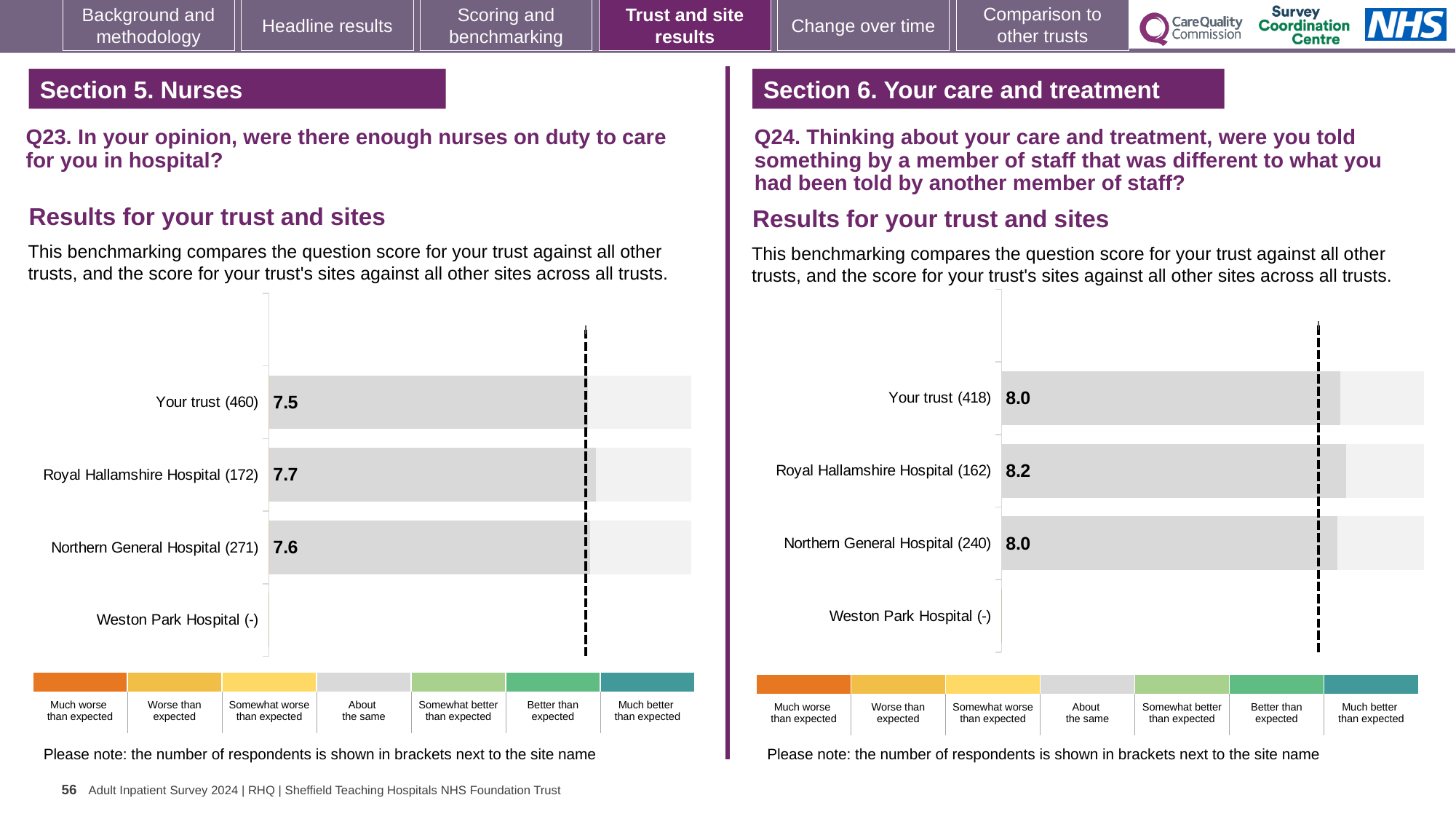
On the Q23 chart (left), what is the score for Royal Hallamshire Hospital? 7.7 On the Q23 chart (left), how many rows (trust and sites) are listed? 4 On the Q24 chart (right), what is the score for Northern General Hospital? 8.0 On the Q23 chart (left), which site or trust row has the highest score? Royal Hallamshire Hospital On the Q24 chart (right), what is the score for Royal Hallamshire Hospital? 8.2 On the Q23 chart (left), how many respondents are shown for Northern General Hospital? 271 On the Q23 chart (left), what is the difference between the Royal Hallamshire Hospital score and the Your trust score? 0.2 On the Q24 chart (right), how many respondents are shown for Your trust? 418 On the Q24 chart (right), what is the difference between the Royal Hallamshire Hospital score and the Northern General Hospital score? 0.2 On the Q23 chart (left), what is the score for Your trust? 7.5 What kind of chart is used on the Q23 chart (left)? Bar chart On the Q24 chart (right), which is larger, the score for Royal Hallamshire Hospital or the score for Your trust? Royal Hallamshire Hospital